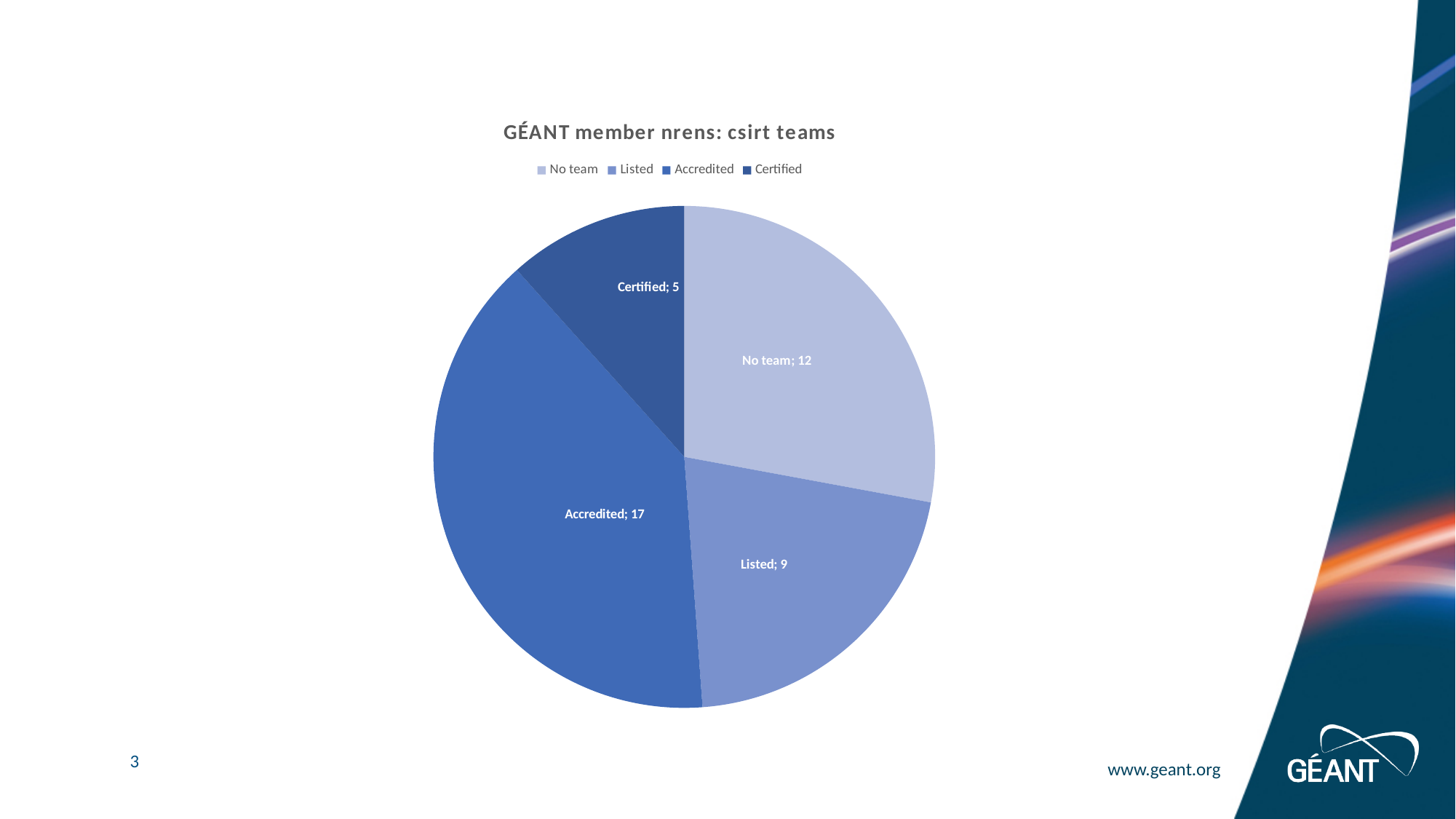
How many slices does the pie chart have? 4 Which is larger, the value for Listed or the value for Certified? Listed What is the total of all slices in the pie chart? 43 Which category has the largest slice? Accredited What is the value for Accredited? 17 What is the difference between the values for Accredited and No team? 5 What is the value for Certified? 5 What is the title of the chart? GÉANT member nrens: csirt teams What is the value for No team? 12 Which category has the smallest slice? Certified What is the value for Listed? 9 What kind of chart is shown on the slide? pie chart